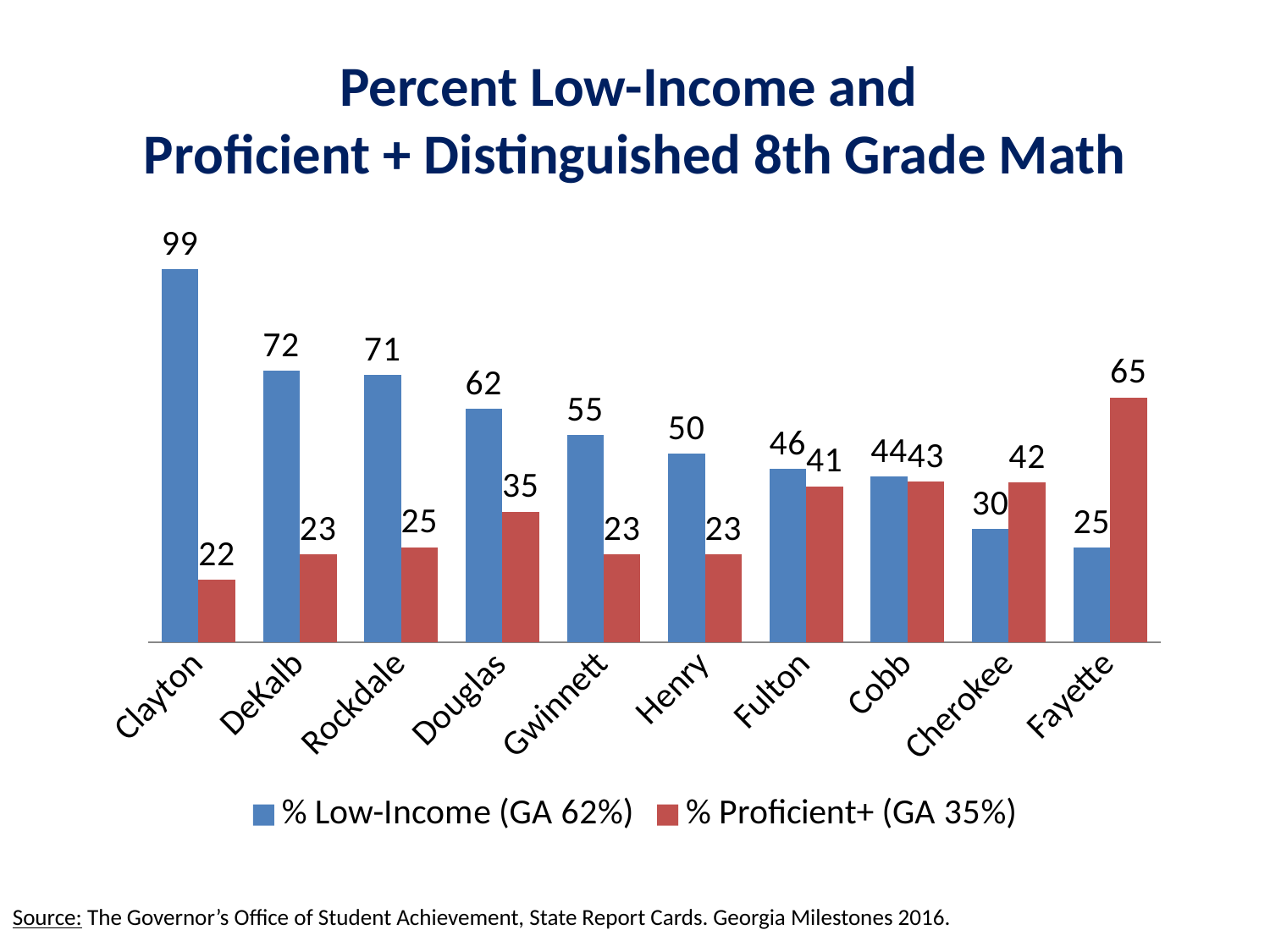
What is the % Proficient+ value for Douglas? 35 Which is larger for Fayette: % Low-Income or % Proficient+? % Proficient+ Do the % Low-Income values generally rise or fall from Clayton to Fayette? Fall What is the % Proficient+ value for Fayette? 65 What kind of chart is shown on the slide? Bar chart Which county has the highest % Low-Income value? Clayton How many series does the legend list? 2 How many counties are shown on the x axis? 10 What is the % Low-Income value for Clayton? 99 What Georgia statewide value is given in the legend for % Proficient+? 35% Which county has the lowest % Proficient+ value? Clayton What is the difference between the % Low-Income and % Proficient+ values for Clayton? 77